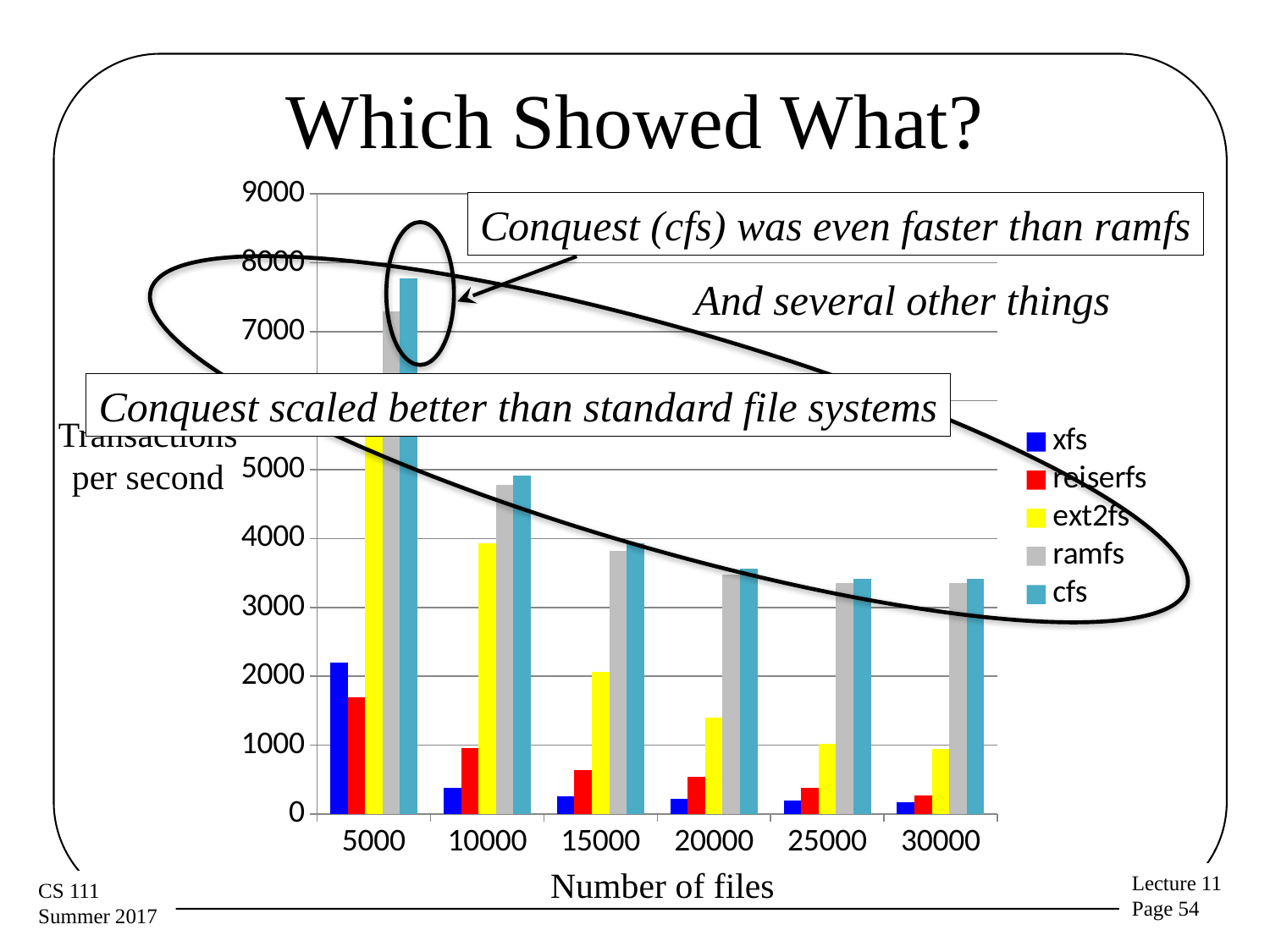
Which file system has the lowest transactions per second at 5000 files? reiserfs Is the value for xfs at 30000 files greater or less than 1000? less Is the value for cfs at 5000 files greater or less than 7000? greater How many categories (number-of-files values) are shown on the x axis? 6 Which file system has the highest transactions per second at 5000 files? cfs What kind of chart is shown on the slide? bar chart Is the value for reiserfs at 5000 files greater or less than 2000? less Do the values for ext2fs rise or fall as the number of files increases? fall What is the title of the x axis? Number of files How many series does the legend list? 5 Which is larger at 5000 files, the value for cfs or the value for xfs? cfs